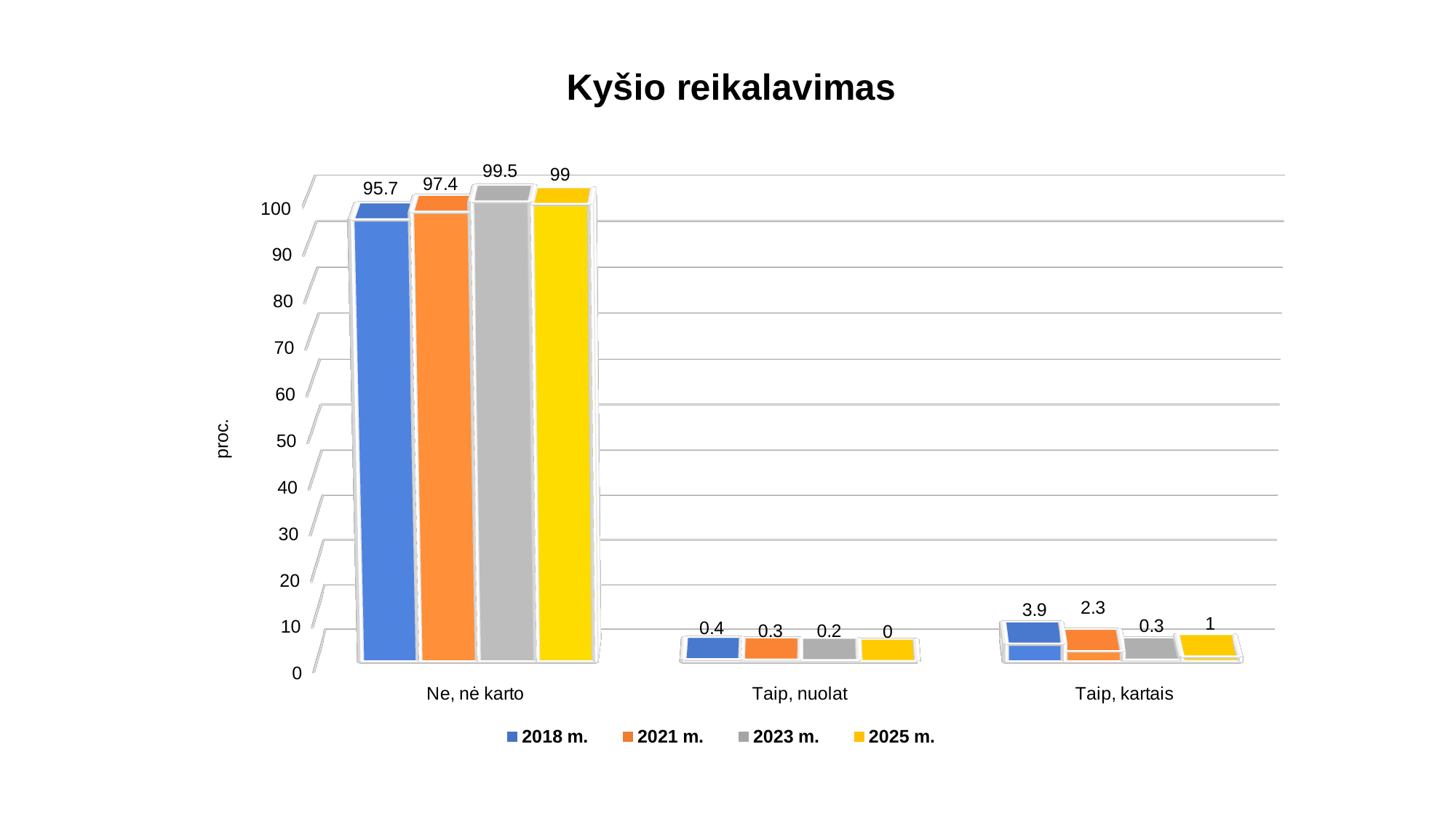
What is the difference between the 2018 m. and 2021 m. values in the 'Taip, kartais' category? 1.6 Which year has the lowest value in the 'Taip, nuolat' category? 2025 m. What is the value for 2018 m. in the 'Ne, nė karto' category? 95.7 How many series does the legend list? 4 What is the value for 2023 m. in the 'Taip, nuolat' category? 0.2 Which is larger in the 'Ne, nė karto' category: the 2021 m. value or the 2025 m. value? 2025 m. How many categories are shown on the x axis? 3 Is the value for 2018 m. in the 'Ne, nė karto' category greater or less than 90? greater What kind of chart is shown on the slide? bar chart What is the title of the chart? Kyšio reikalavimas Which year has the highest value in the 'Ne, nė karto' category? 2023 m. What is the value for 2025 m. in the 'Taip, kartais' category? 1